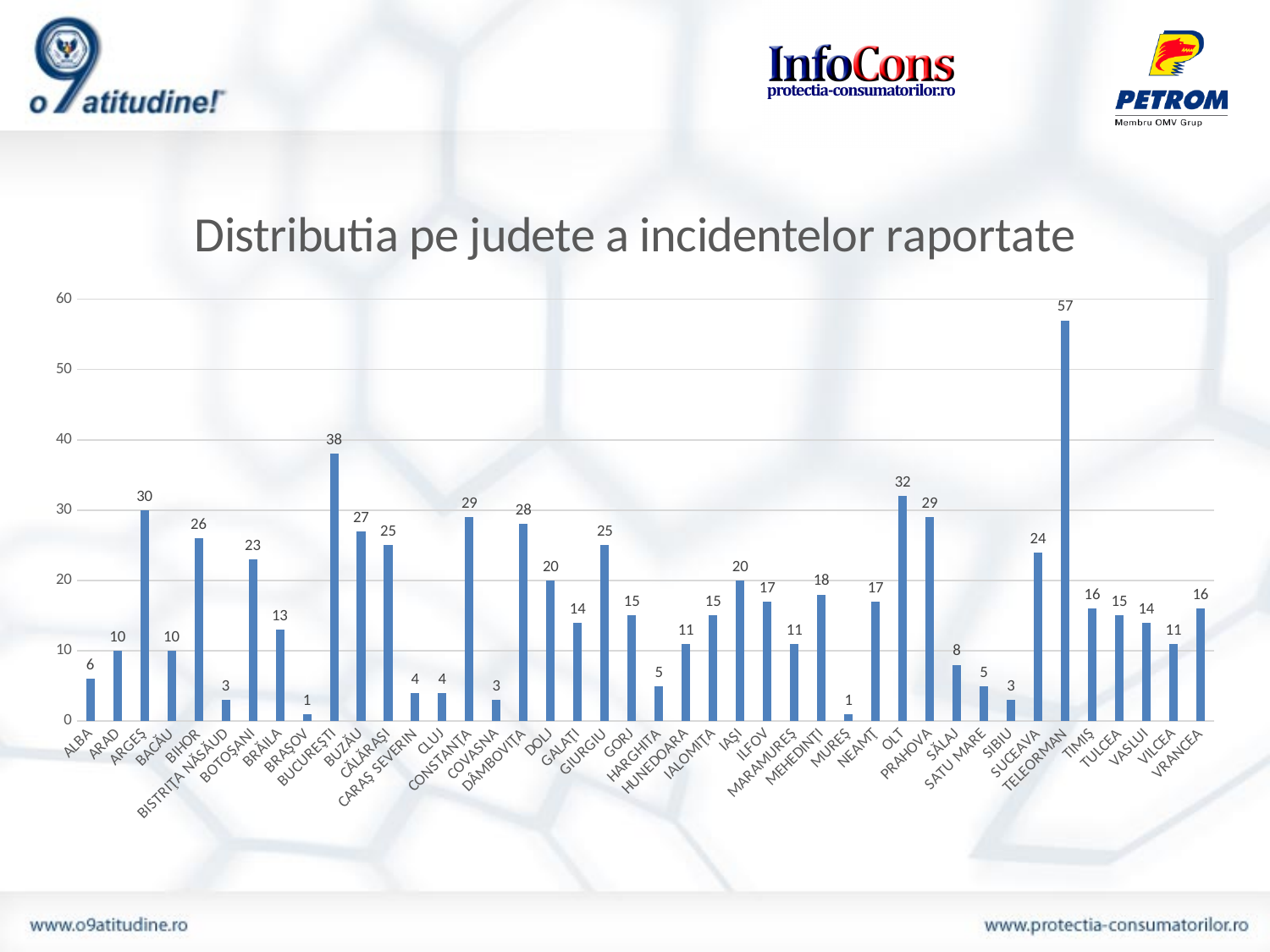
What kind of chart is shown on the slide? Bar chart Which county has the highest number of reported incidents? TELEORMAN What is the value for TELEORMAN? 57 How many counties are shown on the x axis? 42 What is the difference between the values for ARGEȘ and BIHOR? 4 What is the difference between the values for TELEORMAN and BUCUREȘTI? 19 What is the value for BUCUREȘTI? 38 What is the title of the chart? Distributia pe judete a incidentelor raportate Which is larger, the value for CONSTANȚA or the value for DOLJ? CONSTANȚA What is the value for CLUJ? 4 Which is larger, the value for SUCEAVA or the value for PRAHOVA? PRAHOVA What is the value for OLT? 32